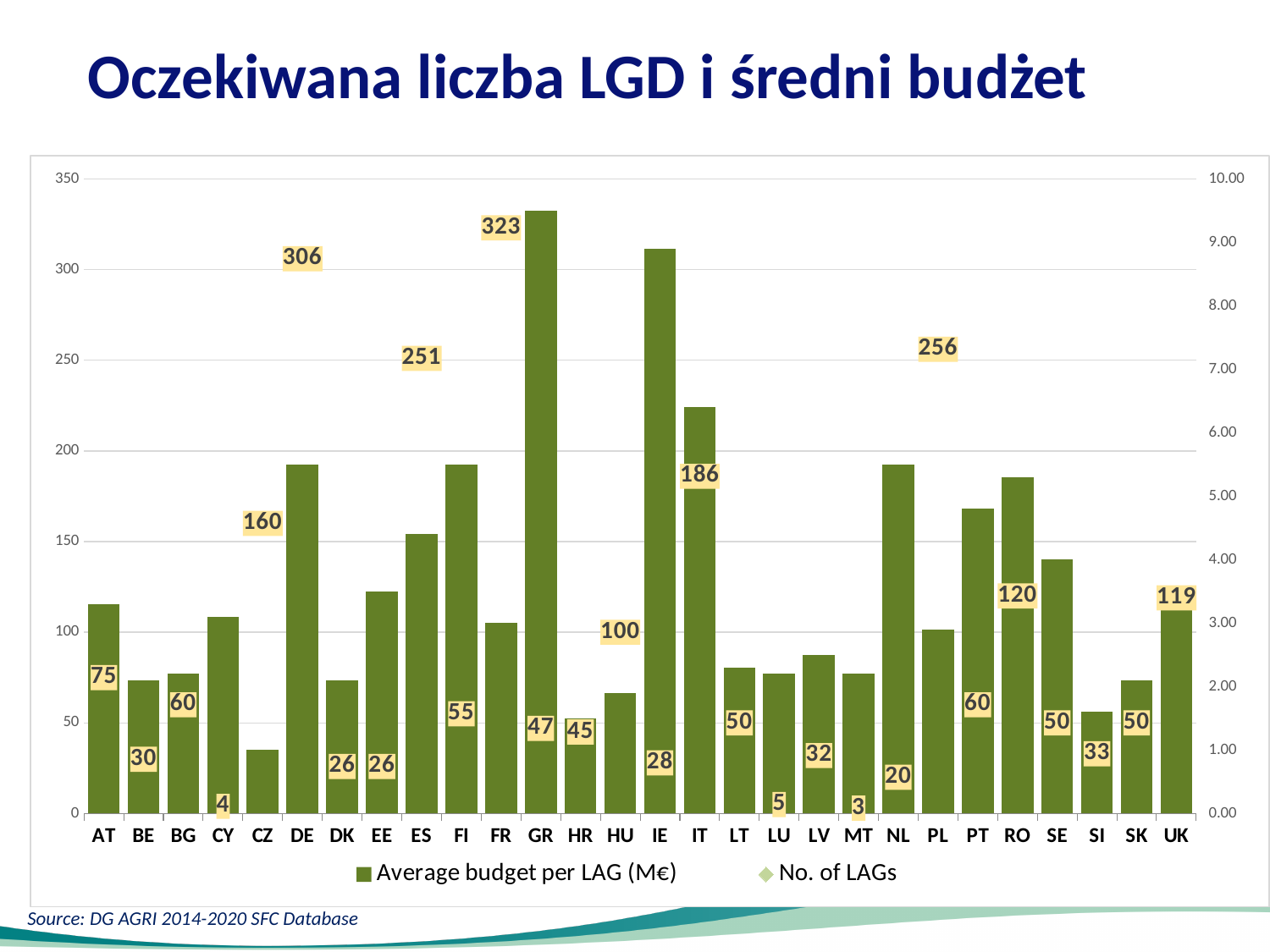
Which country has the lowest No. of LAGs? MT Which country has the highest No. of LAGs? FR What is the No. of LAGs value shown for DE? 306 How many series does the legend list? 2 What is the difference between the No. of LAGs for FR and DE? 17 What is the title of the slide? Oczekiwana liczba LGD i średni budżet What kind of chart is used to show the Average budget per LAG? bar chart Is the Average budget per LAG bar for GR greater or less than 9.00 on the right-hand axis? greater What is the No. of LAGs value shown for FR? 323 How many countries are shown on the x axis? 28 What is the No. of LAGs value shown for CY? 4 Which has a larger No. of LAGs, ES or PL? PL